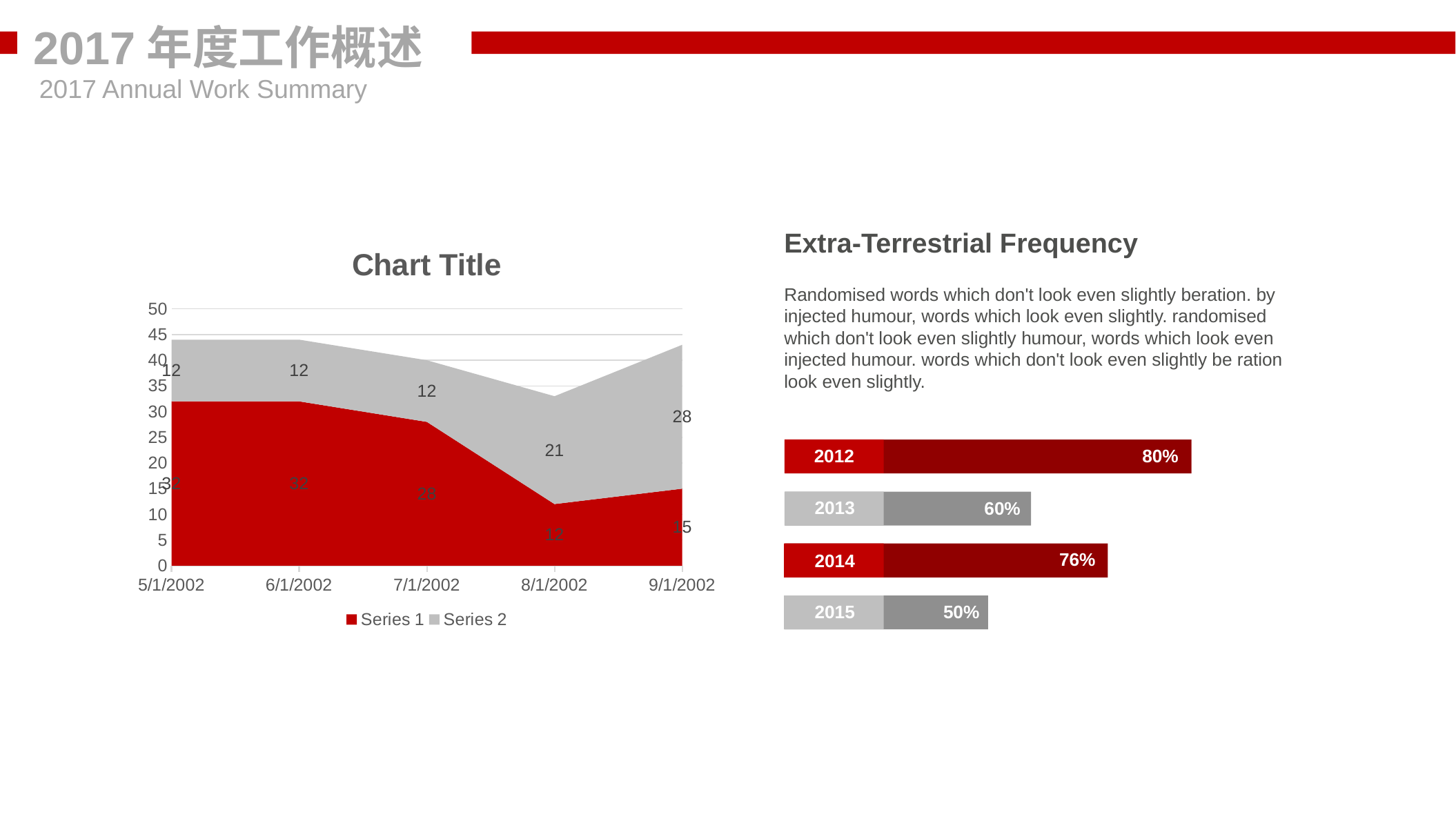
In the chart titled "Chart Title", how many series does the legend list? 2 In the chart titled "Chart Title", what colour represents Series 1 in the legend? red In the chart titled "Chart Title", which series has the larger value at 9/1/2002? Series 2 In the chart titled "Chart Title", at which date is Series 2 highest? 9/1/2002 In the bar chart on the right side of the slide, what is the value for 2012? 80% In the chart titled "Chart Title", what is the difference between the Series 1 values at 5/1/2002 and 8/1/2002? 20 In the chart titled "Chart Title", what is the combined total of Series 1 and Series 2 at 8/1/2002? 33 In the chart titled "Chart Title", at which date is Series 1 lowest? 8/1/2002 In the chart titled "Chart Title", how many dates are shown on the x axis? 5 What kind of chart is the chart titled "Chart Title"? area chart In the chart titled "Chart Title", what is the value of Series 2 at 8/1/2002? 21 In the chart titled "Chart Title", what is the value of Series 1 at 7/1/2002? 28